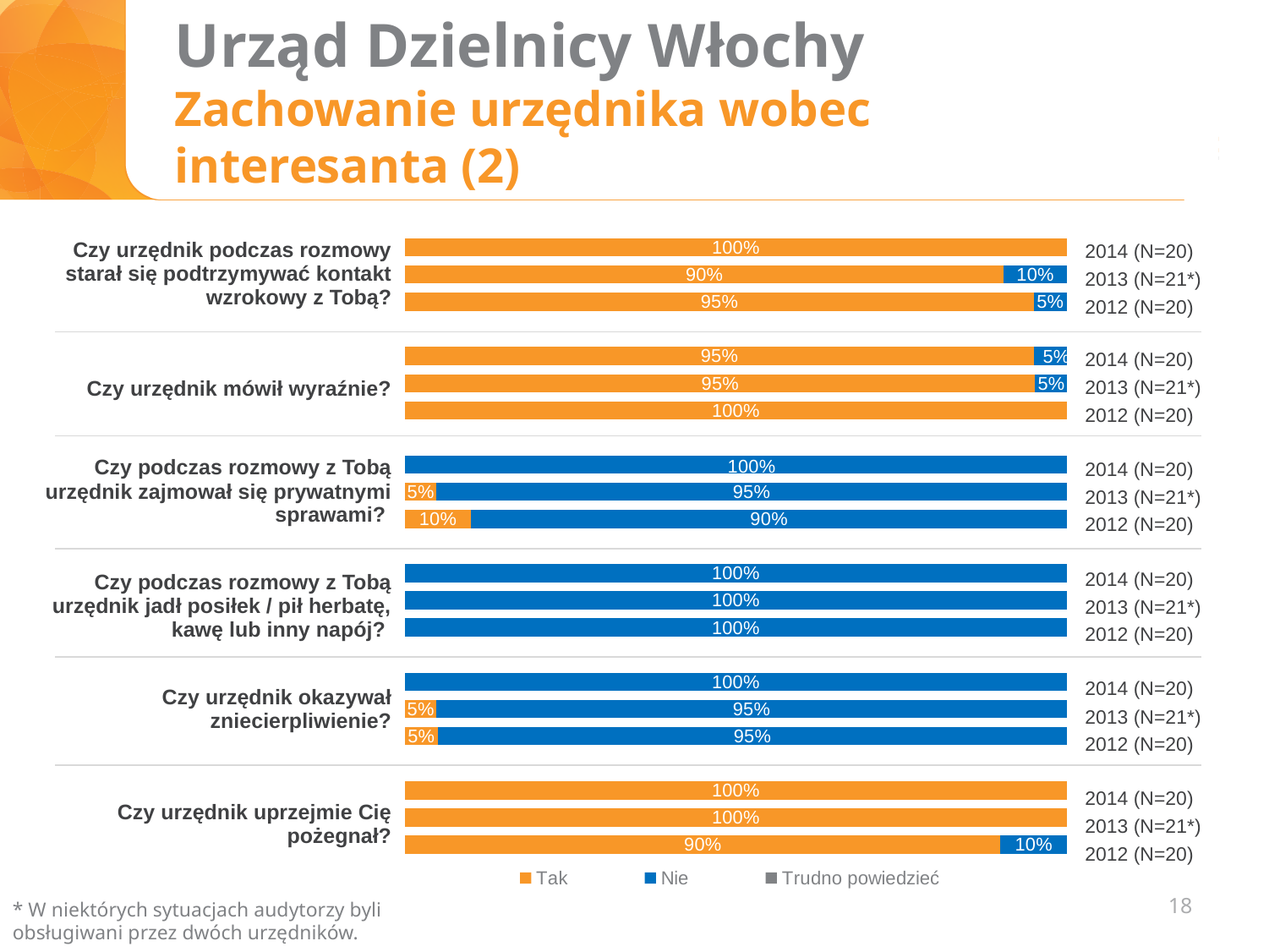
How many survey questions are shown in the chart? 6 For the question "Czy urzędnik podczas rozmowy starał się podtrzymywać kontakt wzrokowy z Tobą?", what is the difference between the "Tak" share in 2014 and in 2013? 10 percentage points For the question "Czy urzędnik okazywał zniecierpliwienie?", what percentage answered "Tak" in 2013? 5% For the question "Czy urzędnik podczas rozmowy starał się podtrzymywać kontakt wzrokowy z Tobą?", what percentage answered "Nie" in 2012? 5% For the question "Czy podczas rozmowy z Tobą urzędnik zajmował się prywatnymi sprawami?", what percentage answered "Nie" in 2012? 90% For the question "Czy urzędnik mówił wyraźnie?", which year had the larger "Tak" share: 2014 or 2012? 2012 How many series does the legend list? 3 For the question "Czy urzędnik podczas rozmowy starał się podtrzymywać kontakt wzrokowy z Tobą?", what percentage answered "Tak" in 2013? 90% Which colour represents the "Tak" answer in the legend? Orange For the question "Czy urzędnik mówił wyraźnie?", what percentage answered "Tak" in 2012? 100% For the question "Czy urzędnik uprzejmie Cię pożegnał?", what percentage answered "Nie" in 2012? 10% What kind of chart is shown on the slide? Stacked bar chart